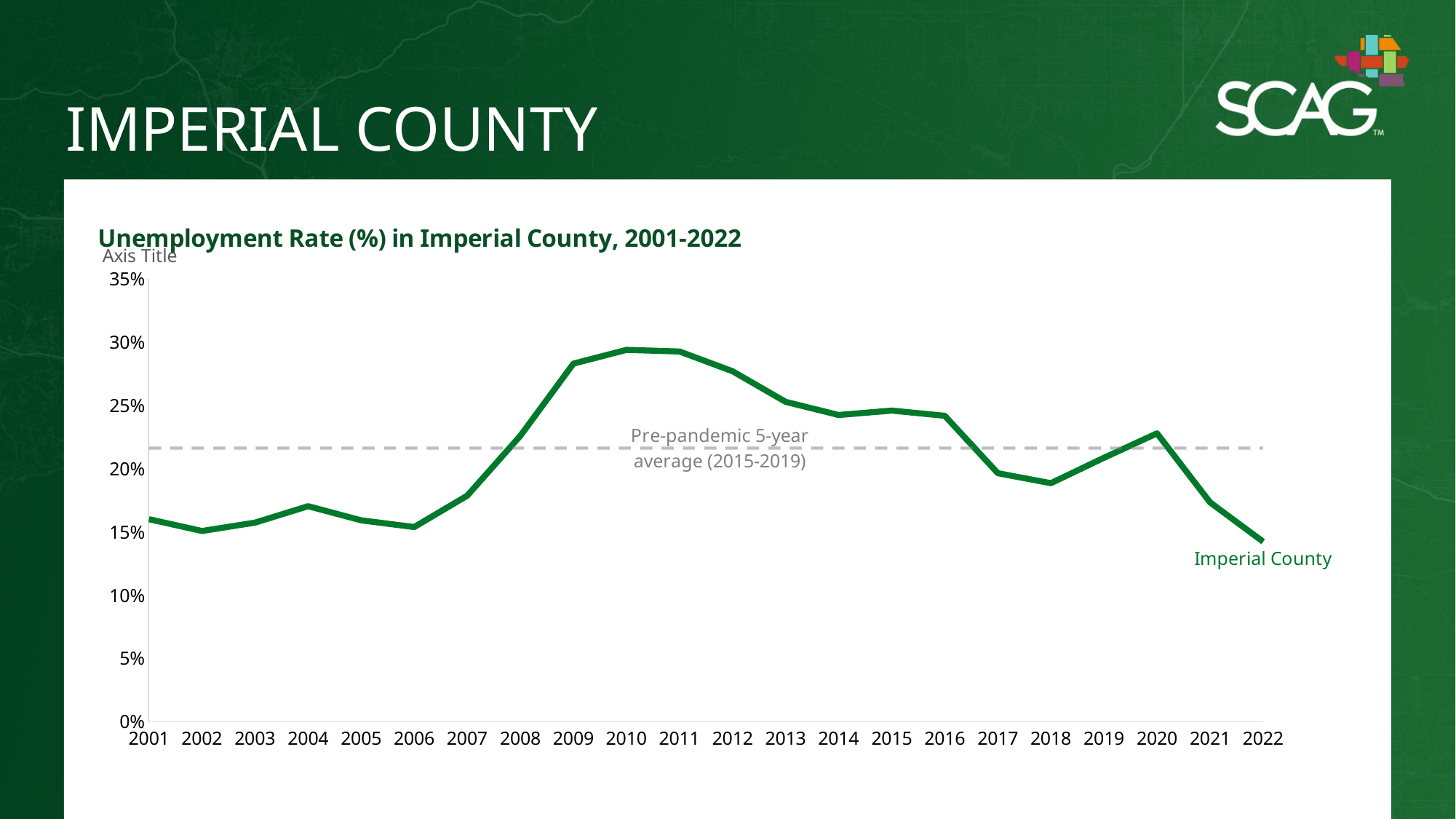
Which year has the higher unemployment rate, 2010 or 2001? 2010 How many years are plotted along the x axis? 22 What is the title of the chart? Unemployment Rate (%) in Imperial County, 2001-2022 Does the unemployment rate rise or fall from 2006 to 2010? Rise What kind of chart is shown on the slide? Line chart Does the unemployment rate rise or fall from 2020 to 2022? Fall Is the unemployment rate for 2001 greater or less than 20%? less Is the unemployment rate for 2010 greater or less than 25%? greater What does the grey dashed horizontal line represent? Pre-pandemic 5-year average (2015-2019) Is the unemployment rate for 2022 greater or less than 20%? less Which year has the higher unemployment rate, 2020 or 2022? 2020